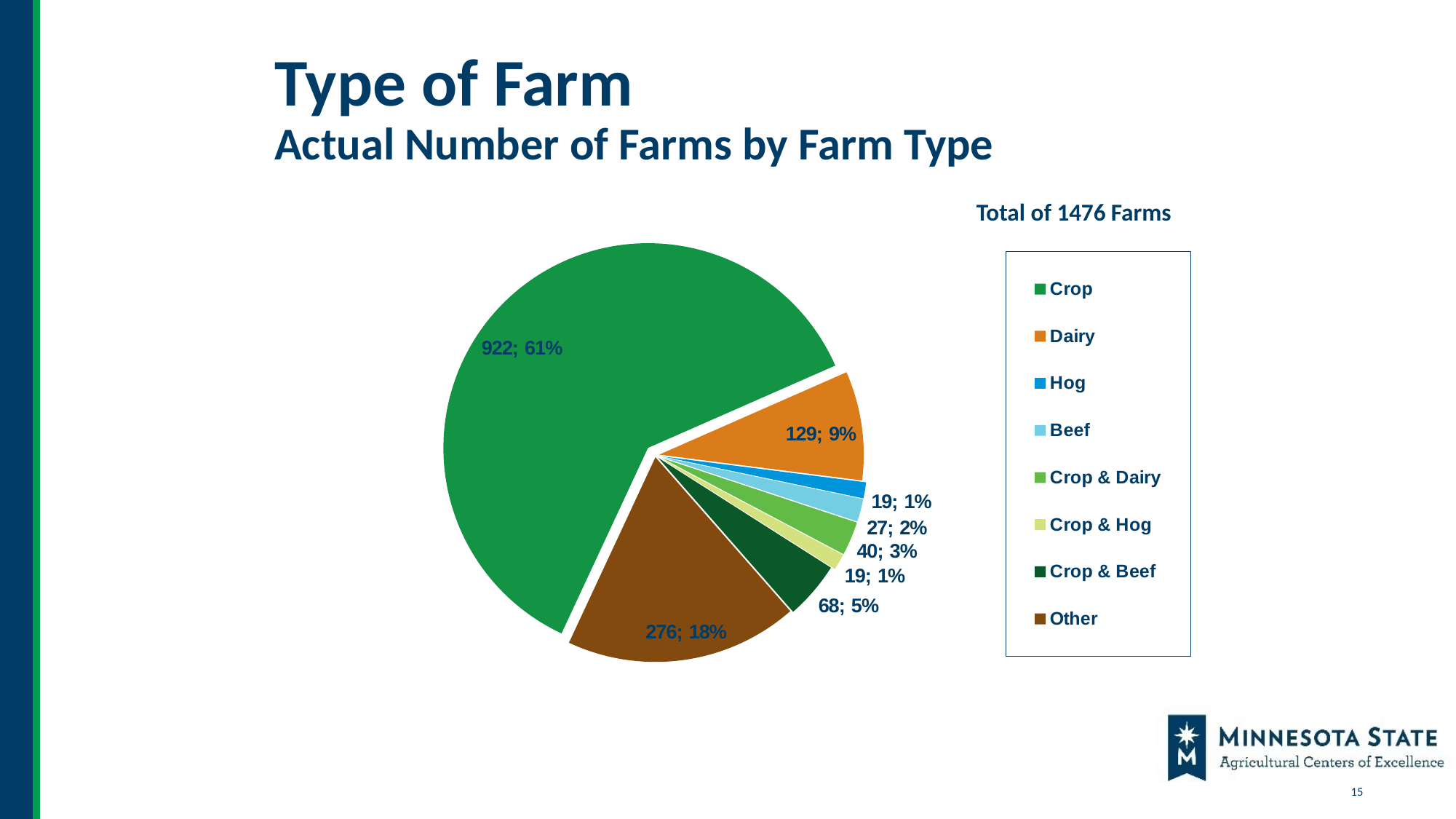
What is the total number of farms stated on the slide? 1476 What is the difference in the number of farms between Other and Dairy? 147 Which has more farms, Beef or Crop & Dairy? Crop & Dairy What percentage of farms are Dairy farms? 9% What colour represents the Other category in the pie chart? Brown Which farm type has the largest number of farms? Crop How many farms are of the Crop & Beef type? 68 How many farms are of the Crop type? 922 How many farm types does the legend list? 8 What share of the pie does the Crop slice represent? 61% What kind of chart is shown on the slide? Pie chart How many farms are in the Other category? 276